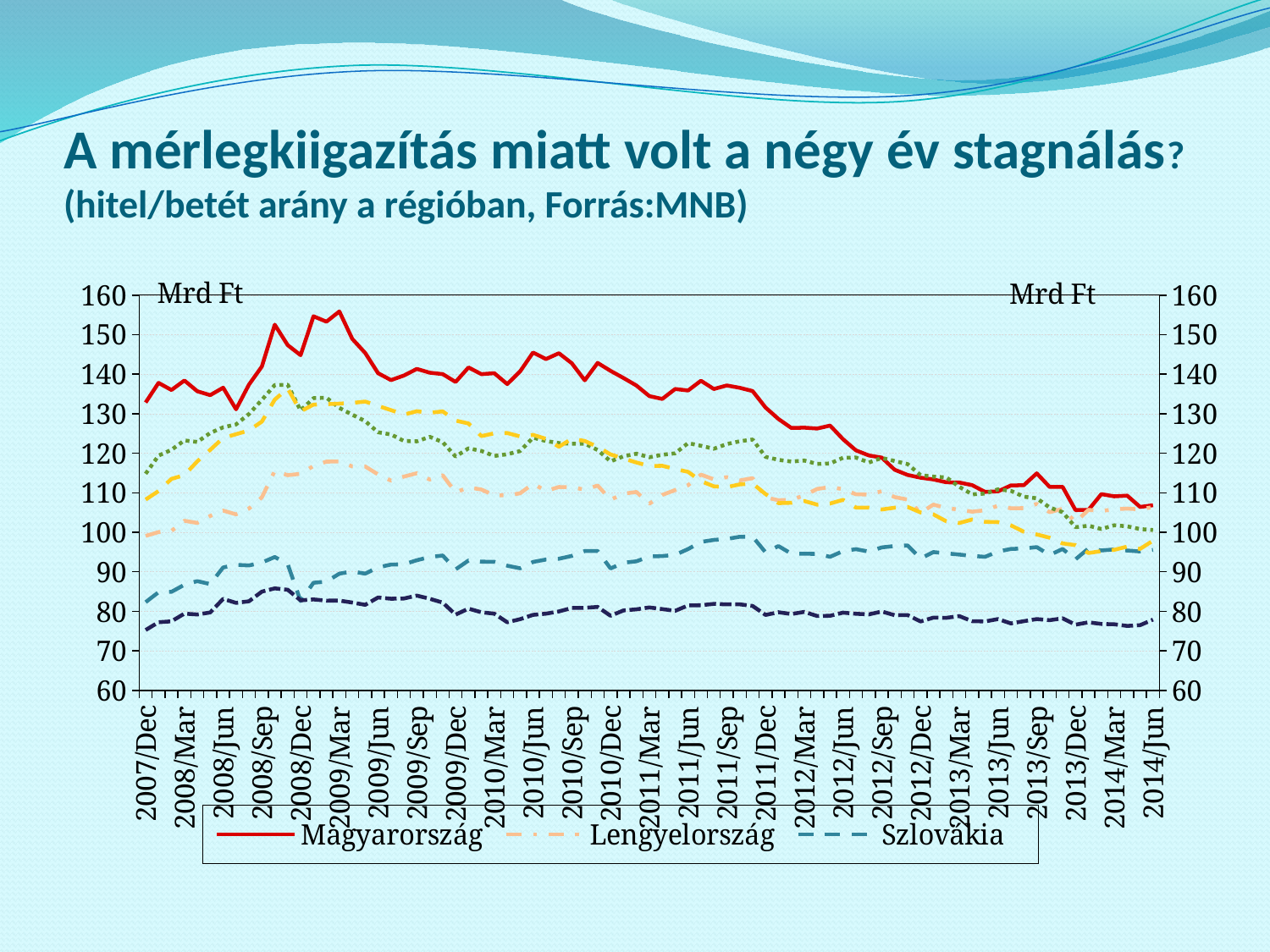
What unit label is shown at the top of the vertical axes? Mrd Ft Is the value for Szlovákia at 2007/Dec greater or less than 90? less Does the Magyarország line rise or fall overall from 2007/Dec to 2014/Jun? fall Is the value for Magyarország at 2014/Jun greater or less than 120? less Does the Szlovákia line rise or fall overall from 2007/Dec to 2014/Jun? rise Is the value for Lengyelország at 2007/Dec greater or less than 110? less What kind of chart is shown on the slide? line chart At 2007/Dec, which is larger: the value for Magyarország or the value for Szlovákia? Magyarország Which series is drawn as a solid red line? Magyarország How many series does the legend list? 3 Among the series listed in the legend, which has the lowest value at 2007/Dec? Szlovákia